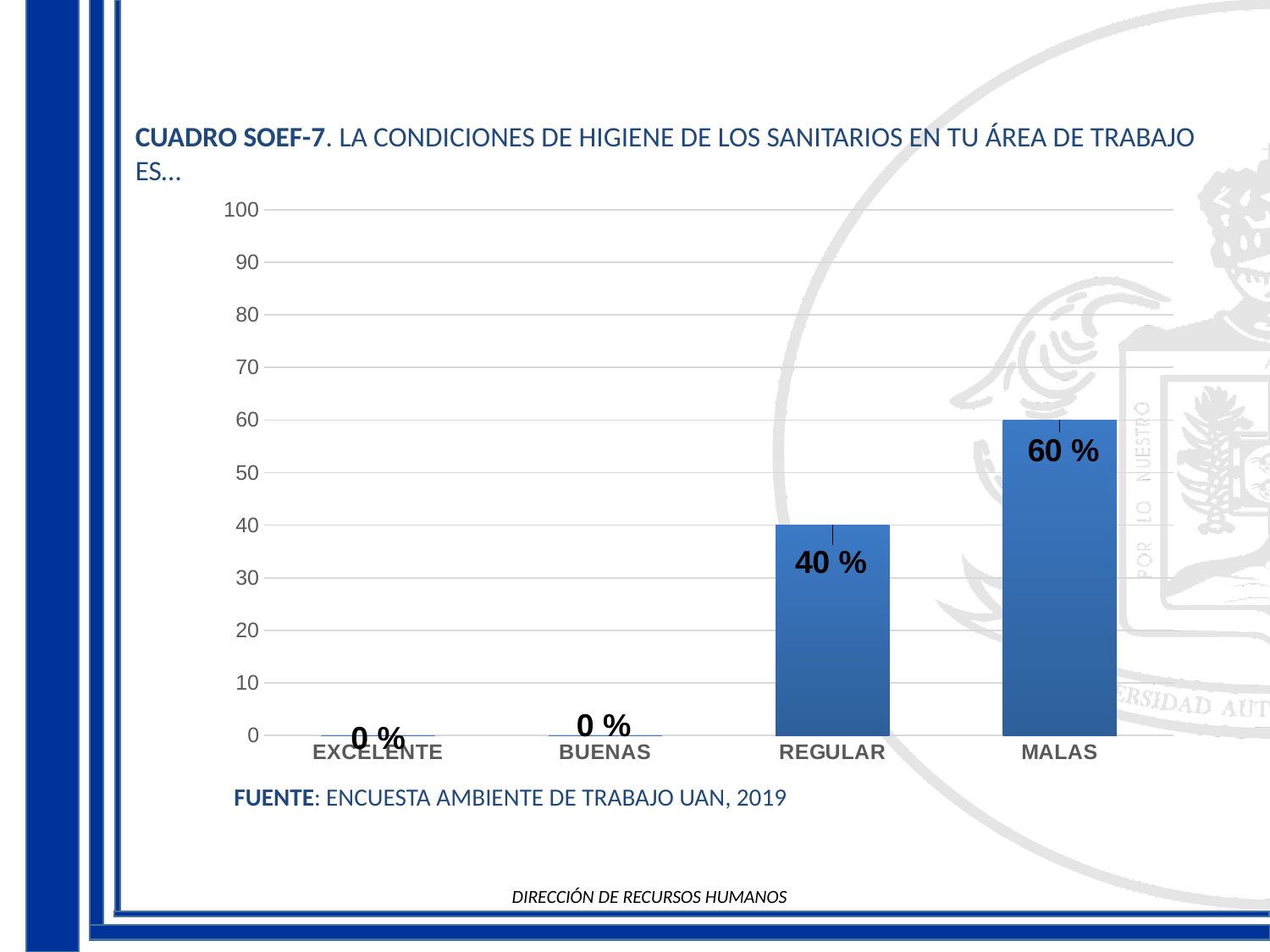
What is the value for MALAS? 60 % Is the value for MALAS greater or less than 50? greater What is the difference between the values for MALAS and REGULAR? 20 % What is the value for EXCELENTE? 0 % What is the value for BUENAS? 0 % Which is larger, the value for REGULAR or the value for MALAS? MALAS What is the value for REGULAR? 40 % What source is cited below the chart? ENCUESTA AMBIENTE DE TRABAJO UAN, 2019 Do the values rise or fall from EXCELENTE to MALAS along the x axis? rise What kind of chart is shown on the slide? bar chart Which category has the highest value? MALAS How many categories are shown on the x axis? 4